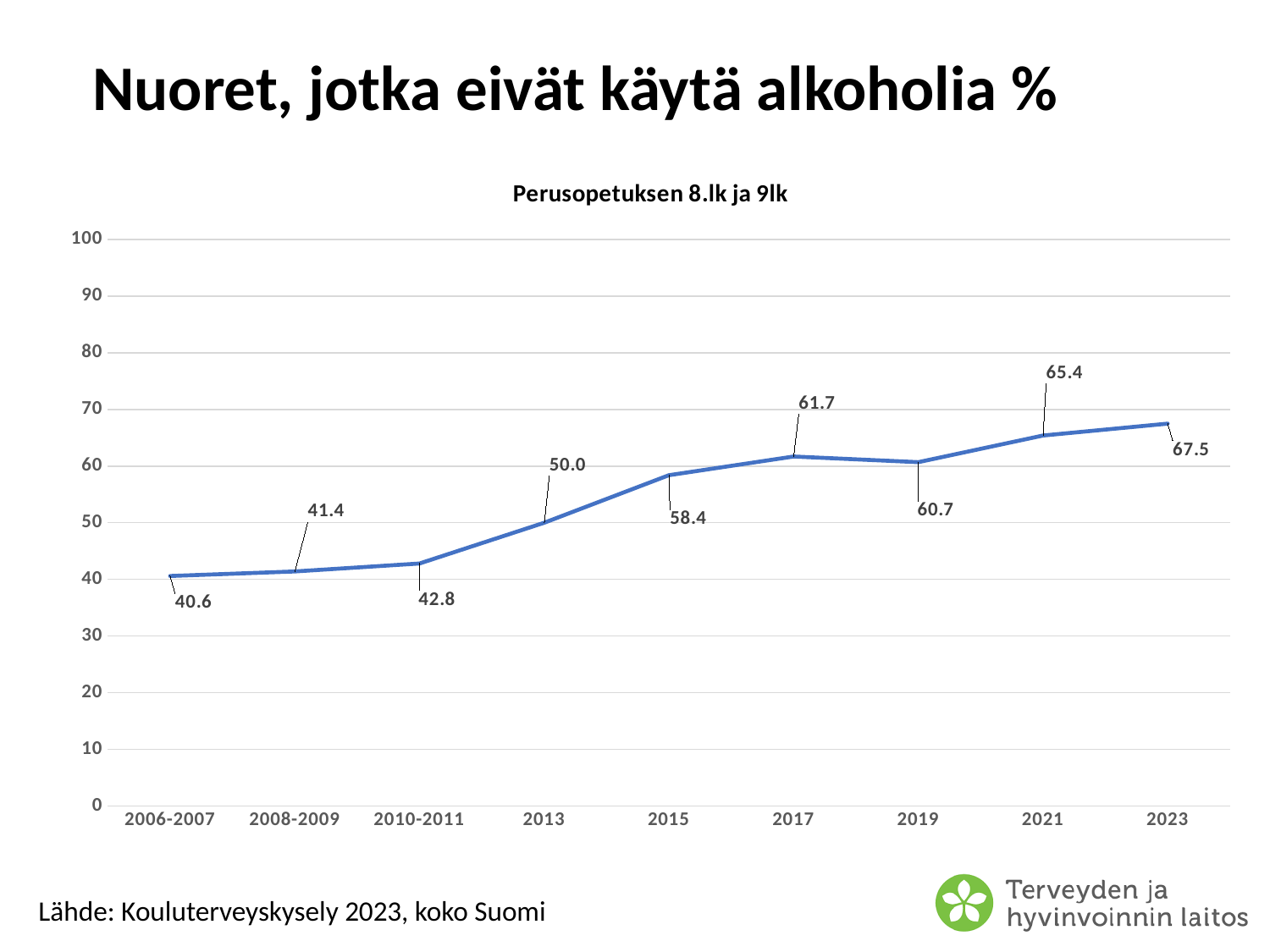
What is the value for 2019? 60.7 Which period has the lowest value? 2006-2007 What is the subtitle shown above the chart? Perusopetuksen 8.lk ja 9lk Which year has the highest value? 2023 What is the value for 2013? 50.0 What is the value for 2006-2007? 40.6 What is the difference between the values for 2023 and 2006-2007? 26.9 How many data points are plotted on the chart? 9 Is the value for 2015 greater or less than 50? greater What is the value for 2023? 67.5 What kind of chart is shown on the slide? line chart Which is larger, the value for 2017 or the value for 2019? 2017